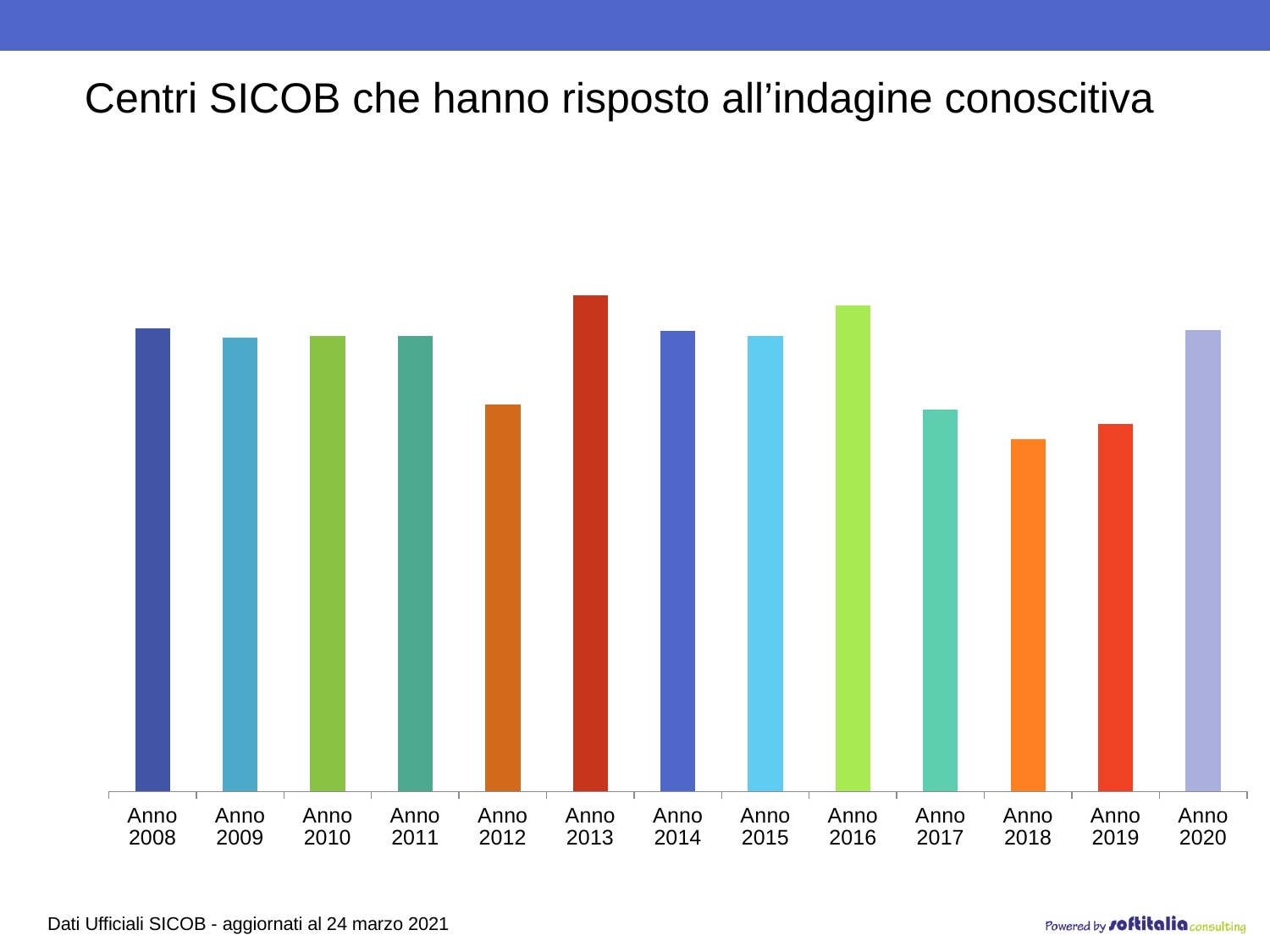
Do the values rise or fall from Anno 2018 to Anno 2020? Rise Which is larger, the value for Anno 2018 or the value for Anno 2020? Anno 2020 What kind of chart is shown on the slide? Bar chart What is the first year shown on the x axis of the chart? Anno 2008 Which year has the highest bar in the chart? Anno 2013 Do the values rise or fall from Anno 2016 to Anno 2018? Fall Which is larger, the value for Anno 2013 or the value for Anno 2012? Anno 2013 Which is larger, the value for Anno 2016 or the value for Anno 2017? Anno 2016 Which year has the lowest bar in the chart? Anno 2018 What is the title of the slide containing the chart? Centri SICOB che hanno risposto all'indagine conoscitiva How many years are shown on the x axis of the chart? 13